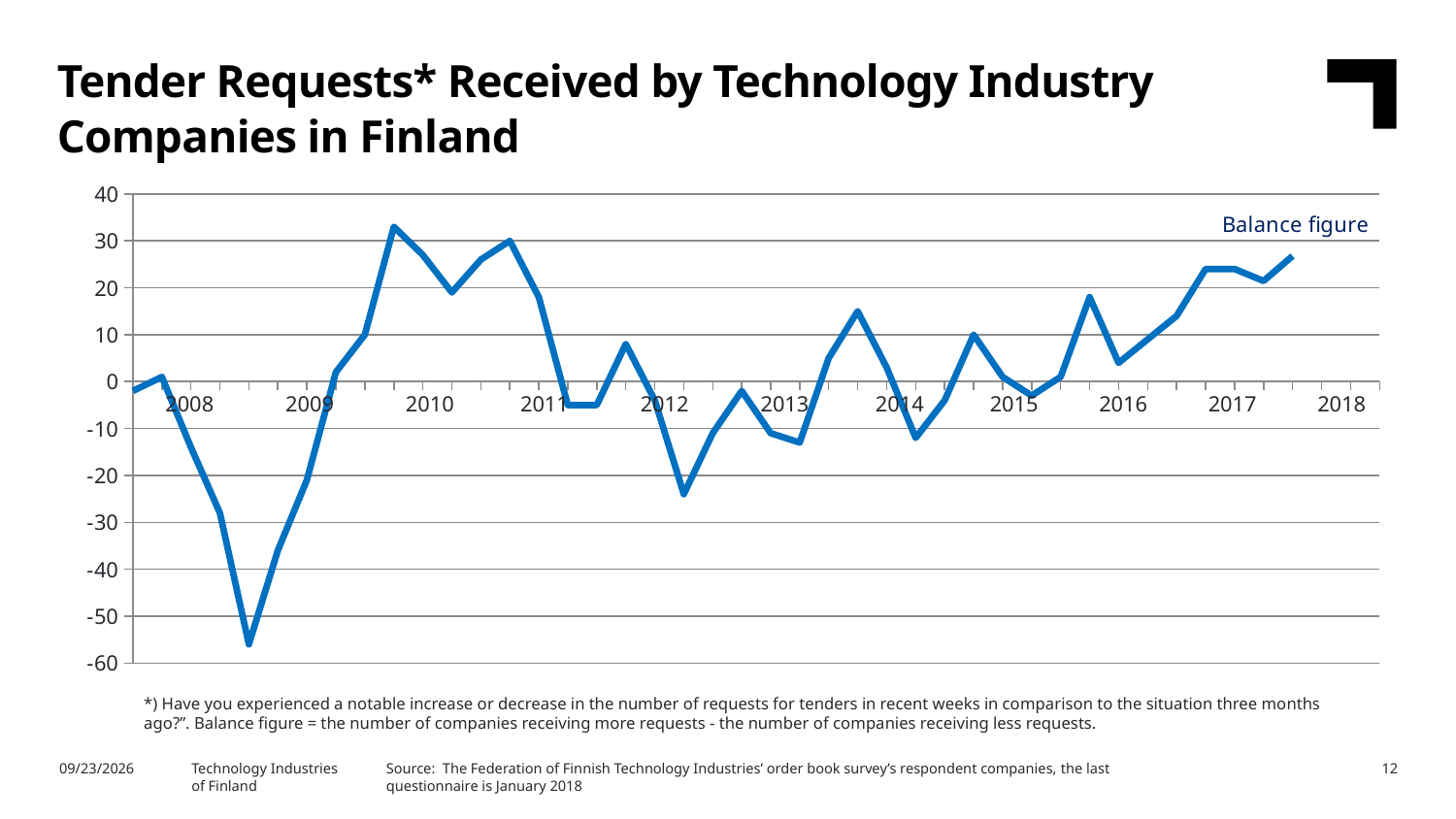
Does the balance figure rise or fall from the start of 2008 to its lowest point? fall Does the balance figure rise or fall between 2016 and 2018? rise How many year labels are shown on the x axis? 11 How many series does the chart plot? 1 Is the highest point of the line greater or less than 30? greater What is the title of the chart on the slide? Tender Requests* Received by Technology Industry Companies in Finland Is the dip in the line around 2012 greater or less than -20? less Is the lowest point of the line greater or less than -50? less What is the name of the series plotted in the chart? Balance figure Is the balance figure at the right end of the line (2018) higher or lower than at the lowest point of the line? higher What kind of chart is shown on the slide? line chart